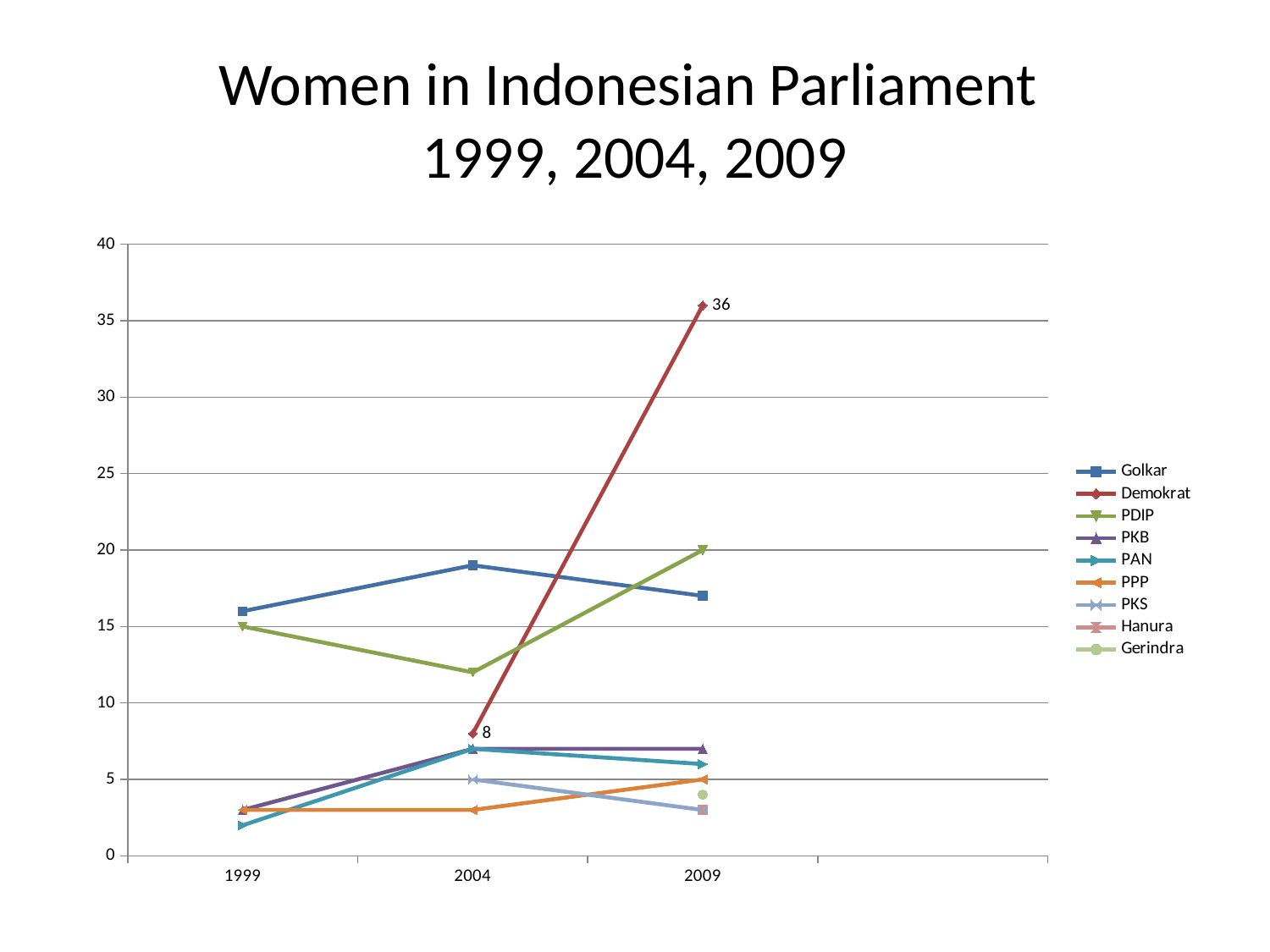
By how much did the Demokrat value increase from 2004 to 2009? 28 What is the value for Demokrat in 2009? 36 What kind of chart is shown on the slide? line chart How many years are labelled on the x axis? 3 Which party has the highest value in 2009? Demokrat What is the value for PDIP in 2009? 20 Does the Demokrat line rise or fall from 2004 to 2009? rise In 2004, which is larger, the value for Golkar or the value for PDIP? Golkar How many series does the legend list? 9 What is the value for Demokrat in 2004? 8 What is the title of the chart? Women in Indonesian Parliament 1999, 2004, 2009 Is the value for Golkar in 1999 greater or less than 15? greater